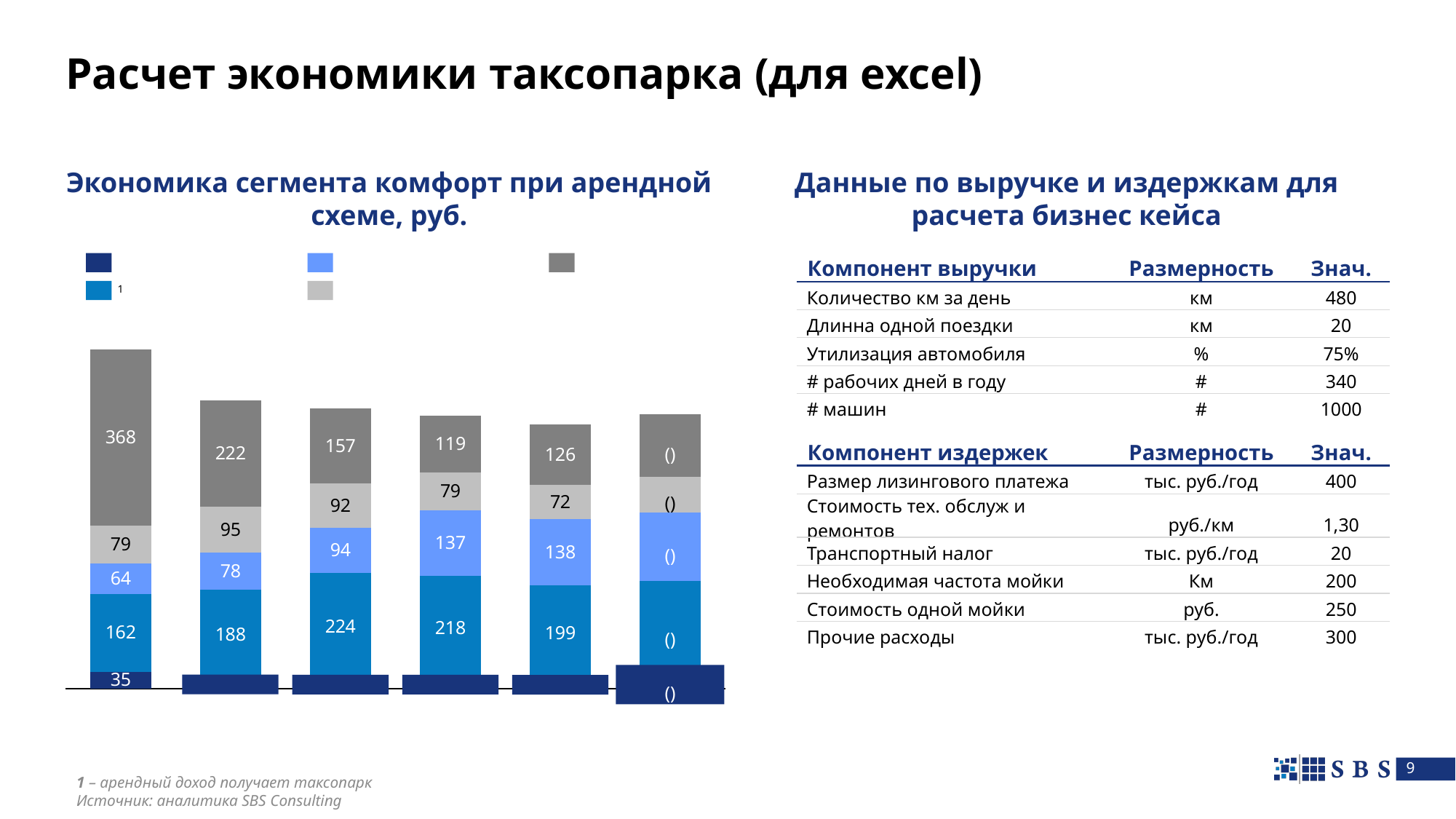
What is the difference between the dark grey segments of the first and second bars? 146 How many bars are plotted in the chart? 6 What is the title of the chart? Экономика сегмента комфорт при арендной схеме, руб. Which bar has the smallest blue segment among the labelled bars? the first bar What kind of chart is shown on the slide? stacked bar chart What is the value of the blue segment of the third bar? 224 Which bar has the largest dark grey (top) segment? the first bar How many series does the chart legend list? 5 Which is larger: the light blue segment of the fourth bar or the light blue segment of the third bar? the fourth bar What is the value of the dark grey (top) segment of the first bar? 368 What is the value of the light grey segment of the second bar? 95 What is the value of the light blue segment of the fifth bar? 138